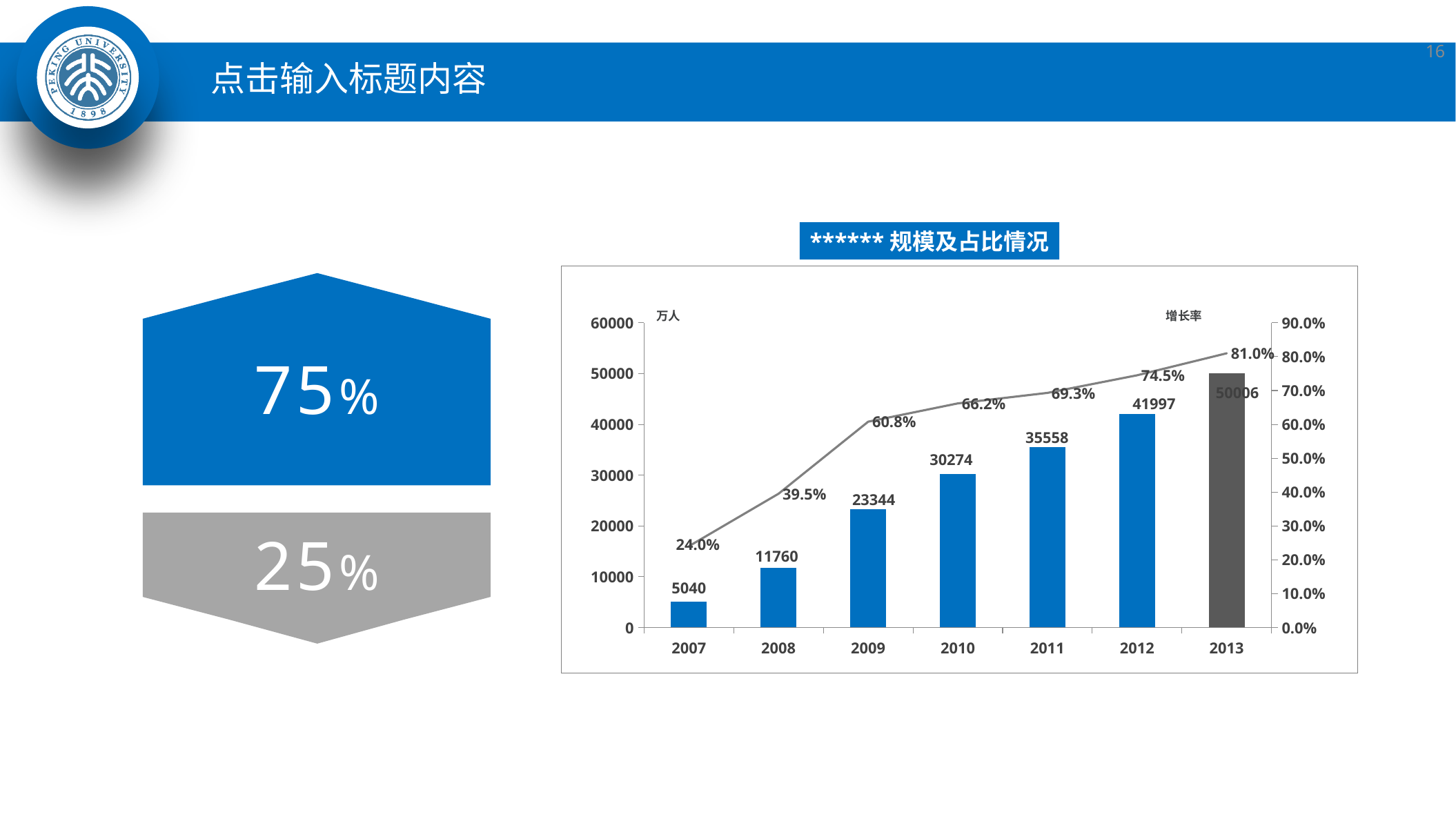
What is the bar value (万人) for 2010? 30274 How many years are shown on the x axis? 7 What is the growth rate (增长率) shown for 2009? 60.8% What unit label is shown at the top of the left axis? 万人 Which is larger, the bar value for 2008 or for 2009? 2009 Which year has the lowest growth rate on the line? 2007 What is the bar value (万人) for 2013? 50006 Do the bar values rise or fall from 2007 to 2013? Rise What is the difference between the bar values for 2012 and 2011? 6439 Which year has the highest bar value? 2013 What kind of chart is this? Combination bar and line chart What is the growth rate shown for 2013? 81.0%